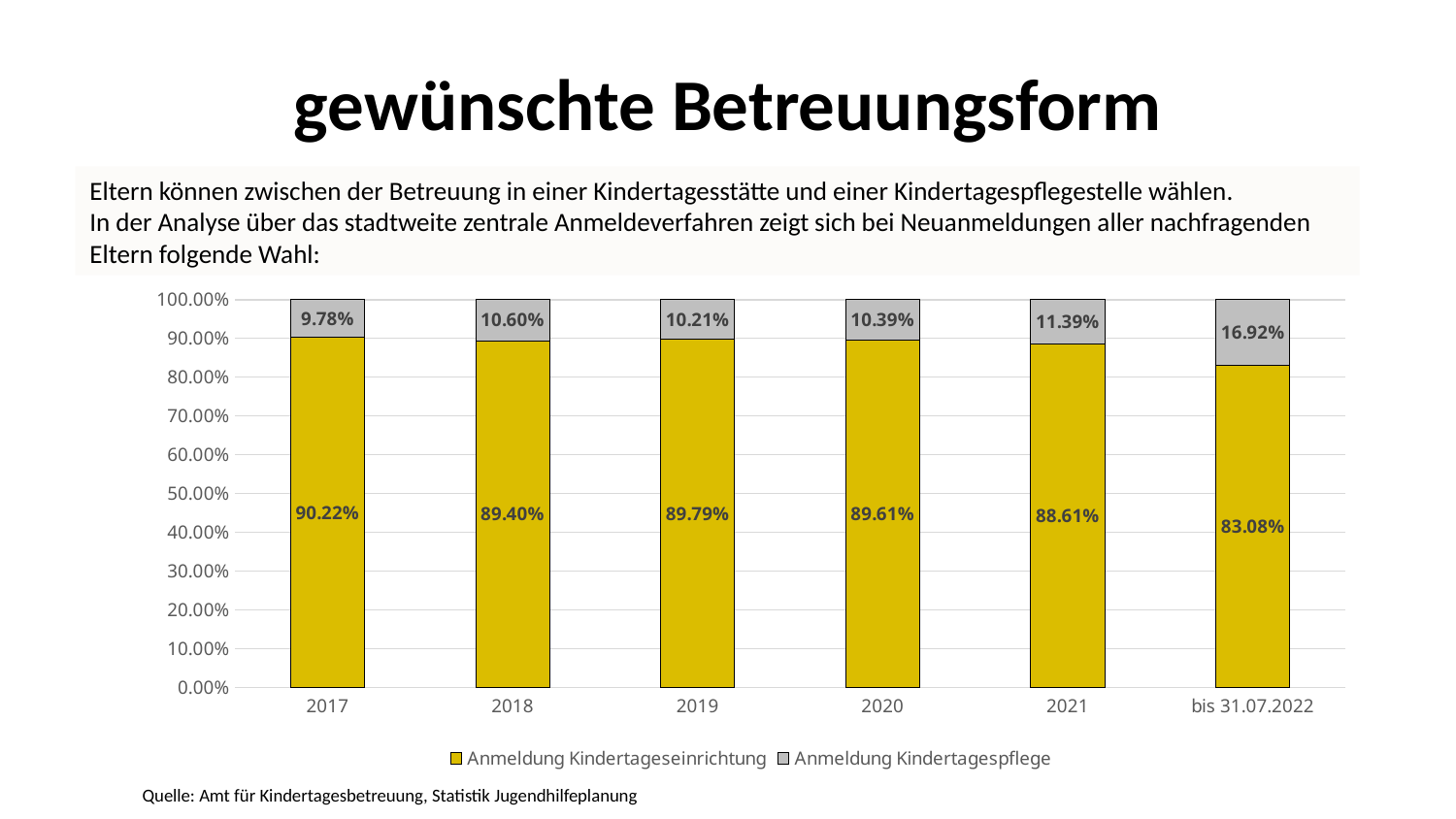
What is the value for Anmeldung Kindertagespflege for bis 31.07.2022? 16.92% What is the value for Anmeldung Kindertagespflege in 2021? 11.39% What is the title of the slide? gewünschte Betreuungsform How many series does the legend list? 2 Which is larger: Anmeldung Kindertagespflege in 2018 or in 2019? 2018 What is the total of the stacked bar for 2020? 100.00% Which category has the highest value for Anmeldung Kindertagespflege? bis 31.07.2022 What kind of chart is shown on the slide? stacked bar chart Which category has the lowest value for Anmeldung Kindertageseinrichtung? bis 31.07.2022 How many categories are shown on the x axis? 6 What is the difference between Anmeldung Kindertageseinrichtung in 2017 and in bis 31.07.2022? 7.14% What is the value for Anmeldung Kindertageseinrichtung in 2017? 90.22%